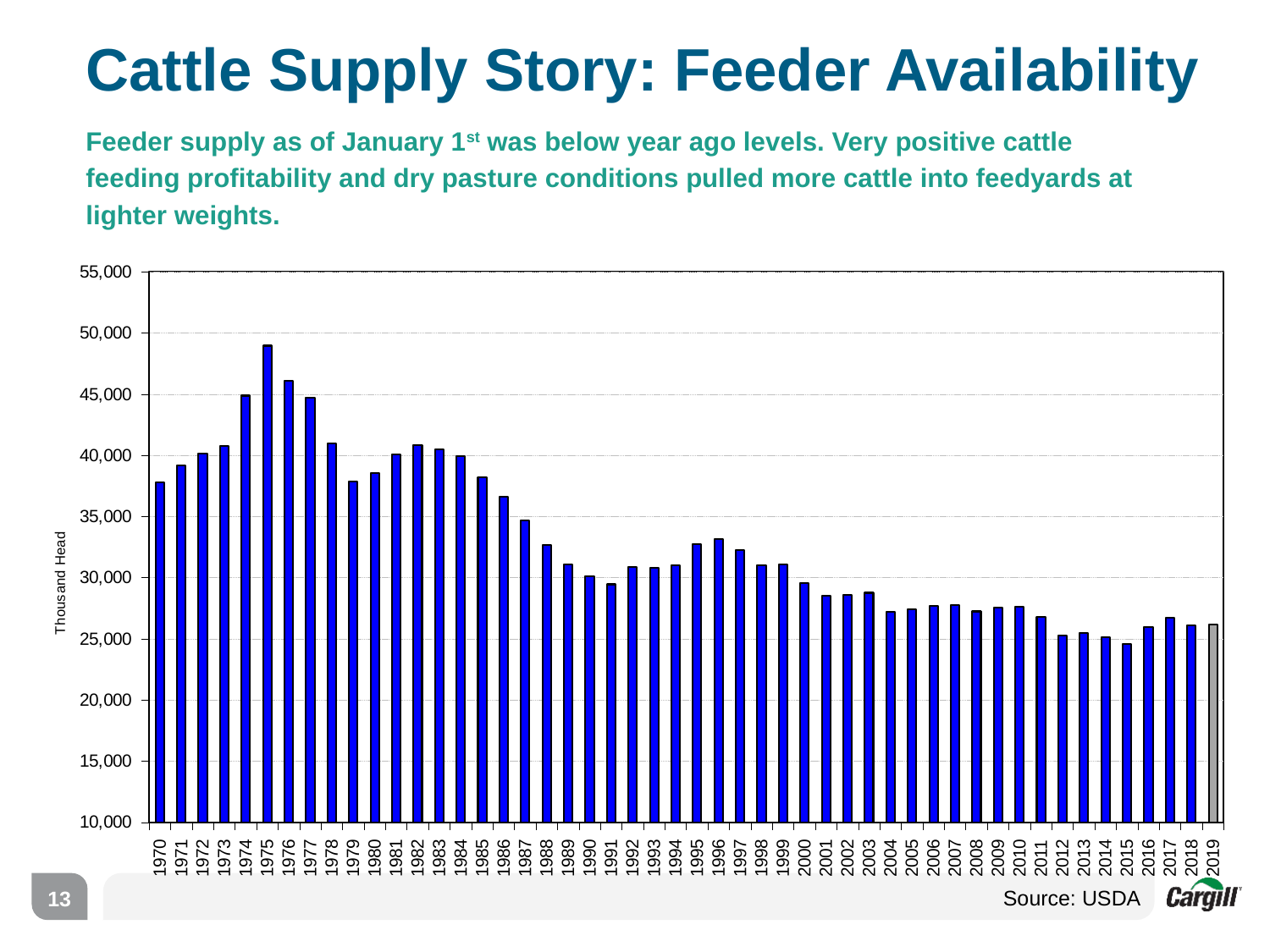
Which year has the highest feeder supply value in the chart? 1975 What is the label on the vertical axis of the chart? Thousand Head Is the value for 1975 greater or less than 45,000? greater Is the value for 1990 greater or less than 35,000? less Which year has the lowest feeder supply value in the chart? 2015 How many years (bars) are plotted in the chart? 50 Which year has the larger value, 1970 or 2019? 1970 Is the value for 1996 greater or less than 30,000? greater What kind of chart is shown on the slide? bar chart Which year has the larger value, 1975 or 1985? 1975 Do the values generally rise or fall from 1975 to 2015? fall